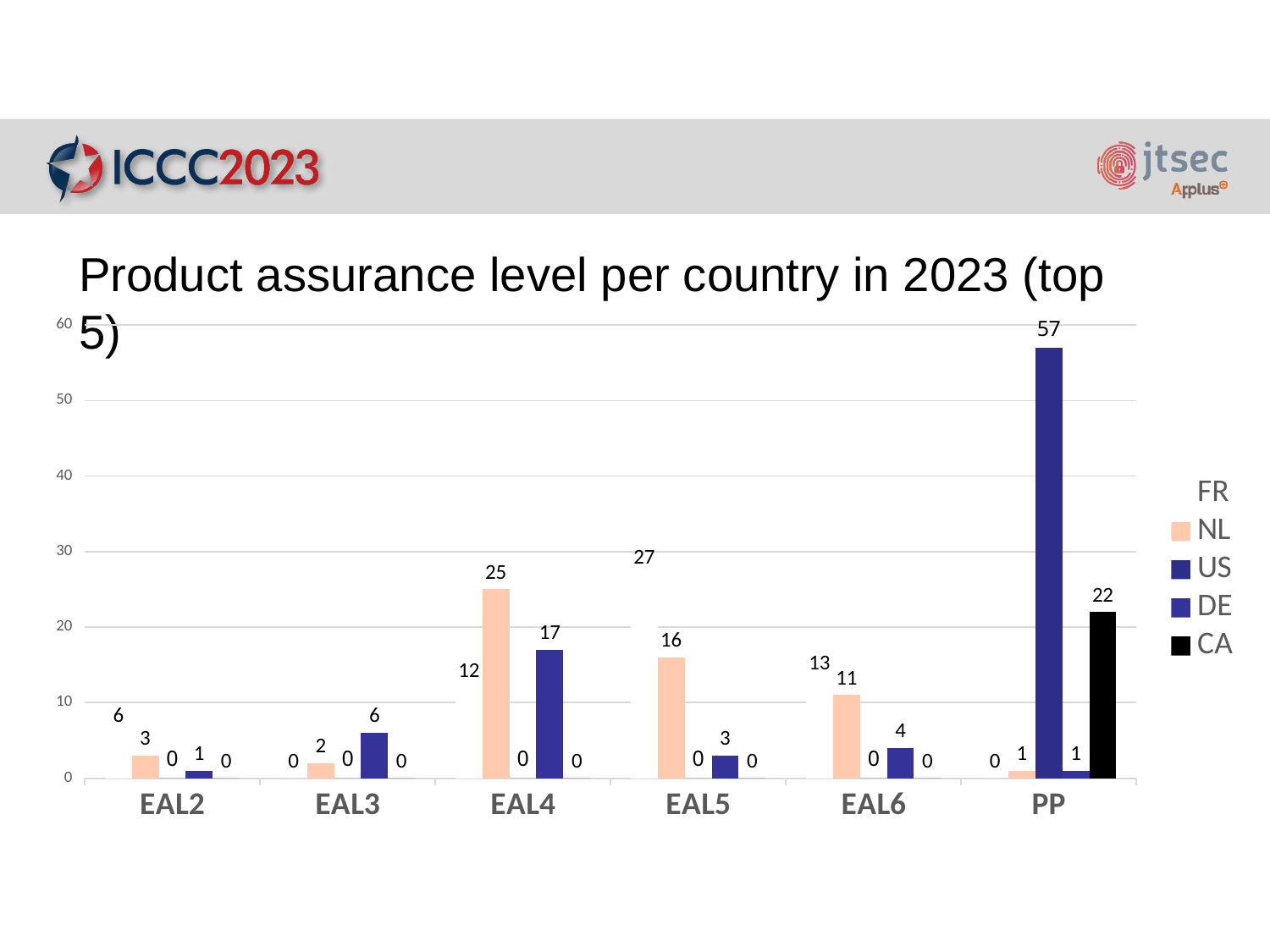
Is the tallest bar at PP greater or less than 50? greater How many categories are shown on the x axis? 6 What is the value for NL at PP? 1 What is the value for CA at PP? 22 Which is larger, the NL value at EAL2 or the NL value at EAL3? EAL2 What is the value for NL at EAL5? 16 How many series does the legend list? 5 Which category contains the highest bar in the chart? PP What kind of chart is shown on the slide? bar chart What is the value for NL at EAL4? 25 What is the difference between the NL values at EAL4 and EAL6? 14 What is the title of the chart? Product assurance level per country in 2023 (top 5)